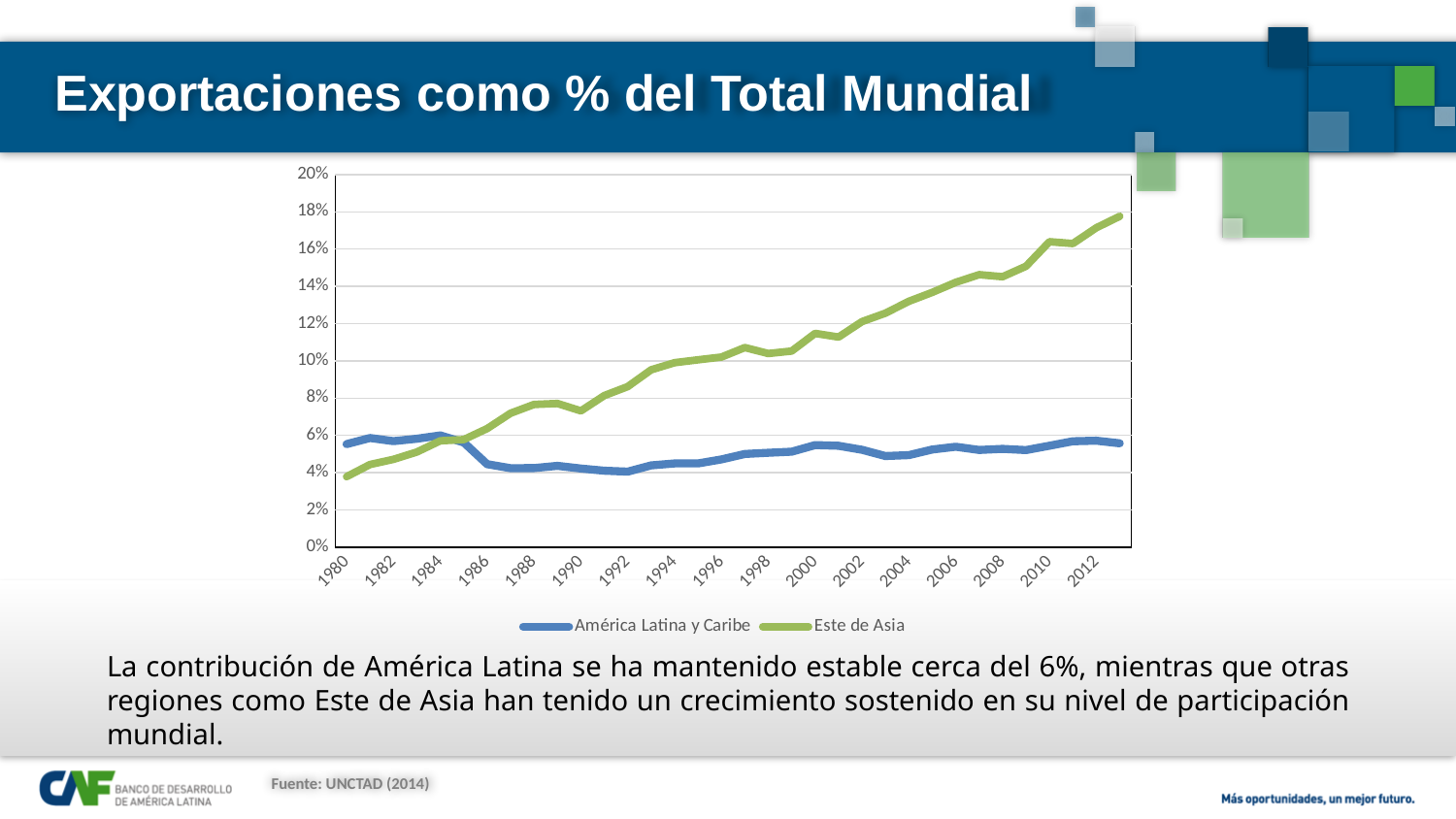
In 2000, which series has the higher value, América Latina y Caribe or Este de Asia? Este de Asia What are the two series named in the legend? América Latina y Caribe and Este de Asia How many series does the legend list? 2 Is the value for Este de Asia in 2008 greater or less than 12%? greater Which series reaches the highest value on the chart? Este de Asia Is the value for América Latina y Caribe in 1992 greater or less than 6%? less What kind of chart is shown on the slide? line chart Is the value for Este de Asia in 2012 greater or less than 16%? greater In 1980, which series has the higher value, América Latina y Caribe or Este de Asia? América Latina y Caribe What is the title of the chart? Exportaciones como % del Total Mundial Does the Este de Asia line rise or fall from 1980 to 2012? rise